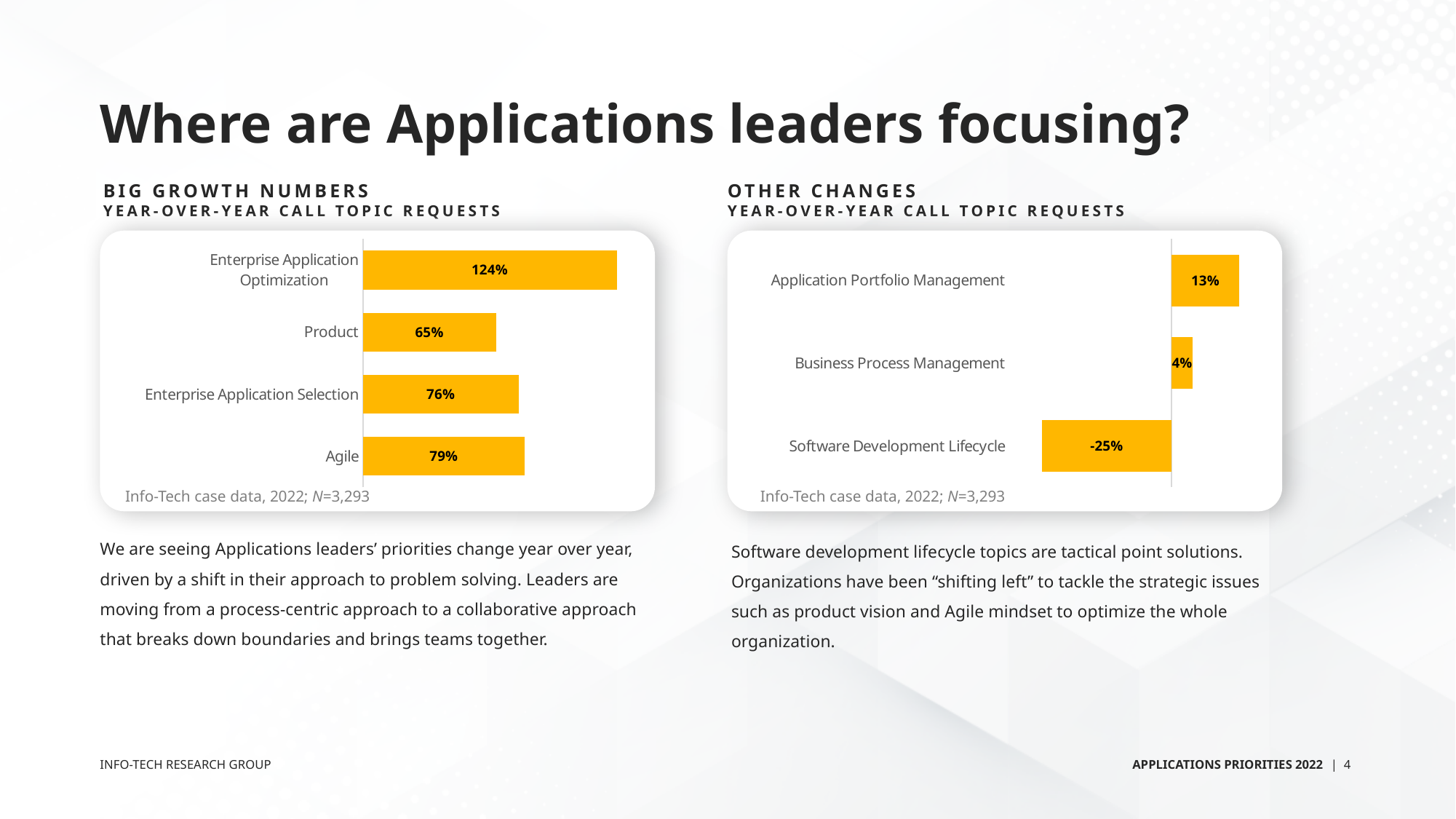
In the 'Other Changes' chart, what is the value for Software Development Lifecycle? -25% In the 'Other Changes' chart, what is the difference between the values for Application Portfolio Management and Business Process Management? 9% In the 'Big Growth Numbers' chart, which category has the highest value? Enterprise Application Optimization In the 'Other Changes' chart, what is the value for Business Process Management? 4% What kind of chart is the 'Other Changes' chart? Bar chart In the 'Big Growth Numbers' chart, what is the value for Product? 65% In the 'Big Growth Numbers' chart, what is the difference between the values for Agile and Enterprise Application Selection? 3% In the 'Big Growth Numbers' chart, which category has the lowest value? Product In the 'Big Growth Numbers' chart, what is the value for Enterprise Application Optimization? 124% In the 'Other Changes' chart, which is larger: the value for Application Portfolio Management or Business Process Management? Application Portfolio Management In the 'Big Growth Numbers' chart, how many categories are shown? 4 In the 'Other Changes' chart, which category has the highest value? Application Portfolio Management